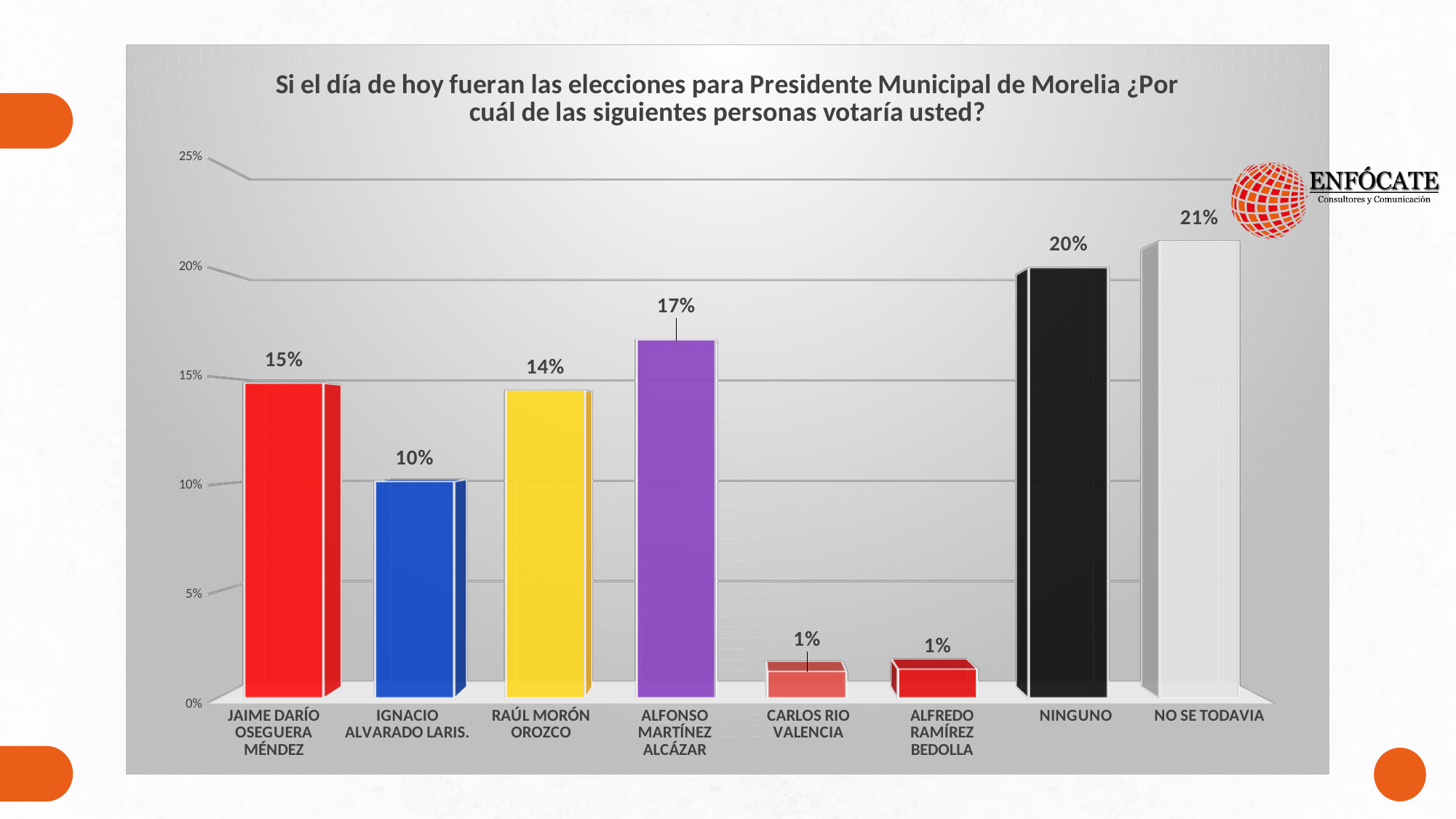
What kind of chart is shown on the slide? Bar chart What percentage is shown for Ninguno? 20% Is the value for Ninguno greater or less than 15%? greater What percentage of respondents would vote for Jaime Darío Oseguera Méndez? 15% Which category has the highest value? No se todavia Which is larger, the value for Jaime Darío Oseguera Méndez or the value for Ignacio Alvarado Laris? Jaime Darío Oseguera Méndez What value is shown for Alfonso Martínez Alcázar? 17% What is the difference between the values for Alfonso Martínez Alcázar and Raúl Morón Orozco? 3% What is the difference between the values for No se todavia and Ninguno? 1% How many categories are shown on the x axis? 8 What colour is the bar for Raúl Morón Orozco? Yellow